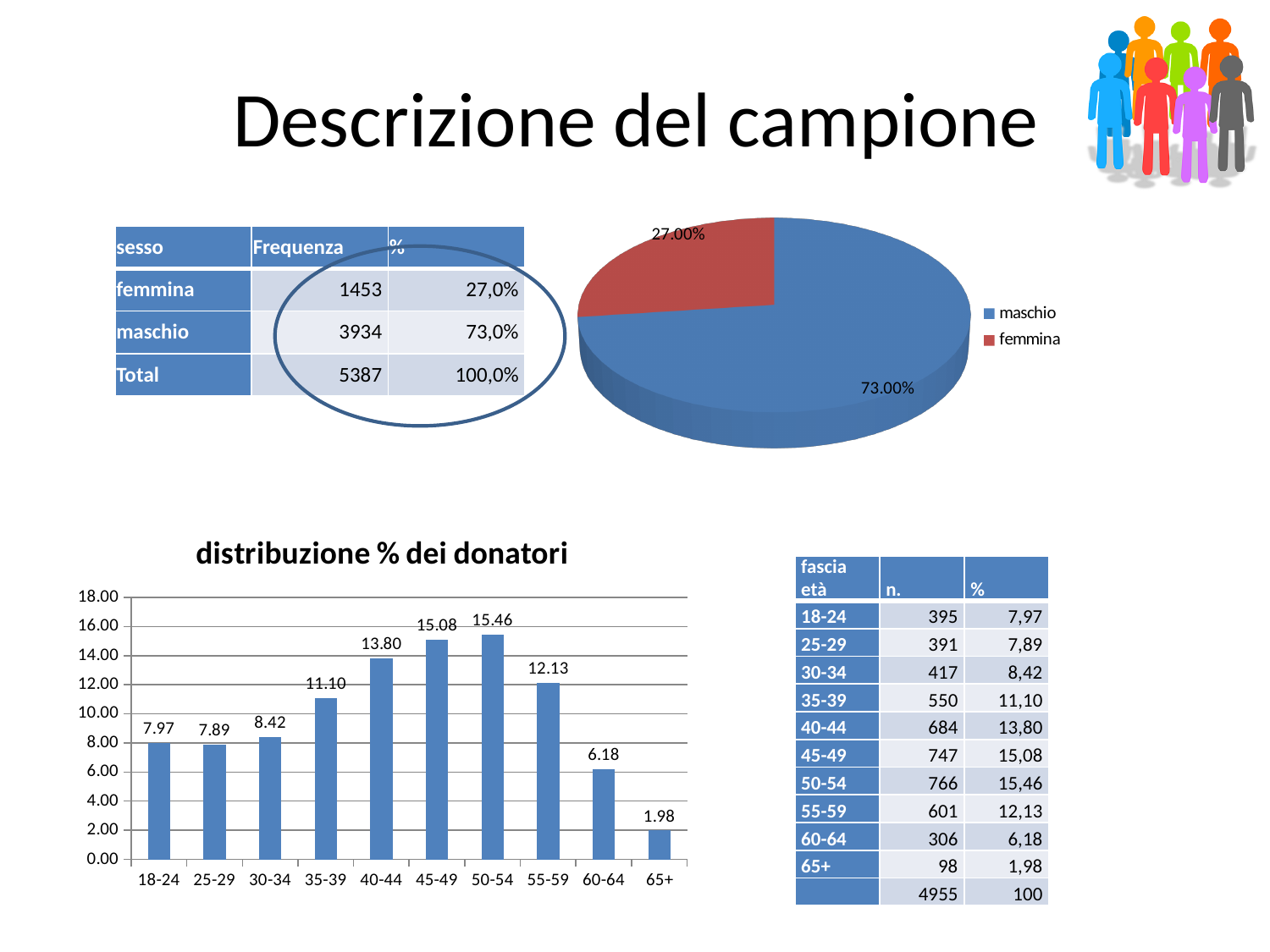
How many entries does the legend of the pie chart at the top right list? 2 In the chart titled 'distribuzione % dei donatori', what is the difference between the values for 50-54 and 55-59? 3.33 In the chart titled 'distribuzione % dei donatori', what is the value for the 40-44 age group? 13.80 In the chart titled 'distribuzione % dei donatori', which is larger, the value for 35-39 or the value for 60-64? 35-39 In the chart titled 'distribuzione % dei donatori', which age group has the lowest value? 65+ What kind of chart is the chart titled 'distribuzione % dei donatori'? bar chart In the chart titled 'distribuzione % dei donatori', which age group has the highest value? 50-54 In the pie chart at the top right, which slice is larger, maschio or femmina? maschio What kind of chart is the chart at the top right of the slide? pie chart In the pie chart at the top right, what share is shown for femmina? 27.00% In the pie chart at the top right, what share is shown for maschio? 73.00% How many age groups are plotted in the chart titled 'distribuzione % dei donatori'? 10